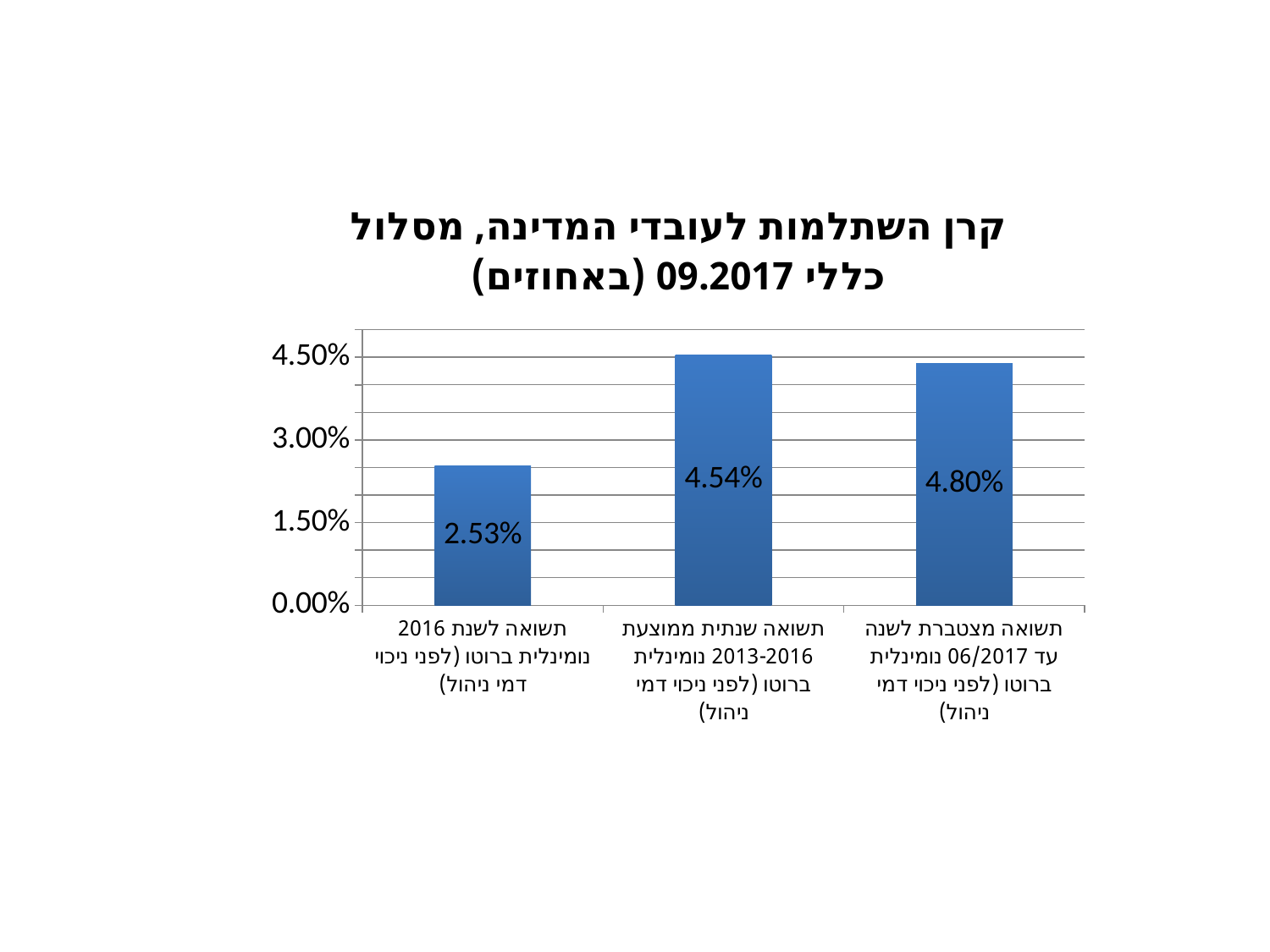
What is the title of the chart? קרן השתלמות לעובדי המדינה, מסלול כללי 09.2017 (באחוזים) How many bars are shown in the chart? 3 What is the value for 'תשואה לשנת 2016 נומינלית ברוטו (לפני ניכוי דמי ניהול)'? 2.53% Which category has the lowest value? תשואה לשנת 2016 נומינלית ברוטו (לפני ניכוי דמי ניהול) What is the value for 'תשואה מצטברת לשנה עד 06/2017 נומינלית ברוטו (לפני ניכוי דמי ניהול)'? 4.80% What kind of chart is shown on the slide? bar chart Which is larger: the value for 'תשואה לשנת 2016' or the value for 'תשואה שנתית ממוצעת 2013-2016'? תשואה שנתית ממוצעת 2013-2016 Is the value for 'תשואה לשנת 2016' greater or less than 3.00%? less What is the difference between the value for 'תשואה שנתית ממוצעת 2013-2016' and the value for 'תשואה לשנת 2016'? 2.01% What is the difference between the value for 'תשואה מצטברת לשנה עד 06/2017' and the value for 'תשואה לשנת 2016'? 2.27% What is the value for 'תשואה שנתית ממוצעת 2013-2016 נומינלית ברוטו (לפני ניכוי דמי ניהול)'? 4.54% Is the value for 'תשואה מצטברת לשנה עד 06/2017' greater or less than 3.00%? greater